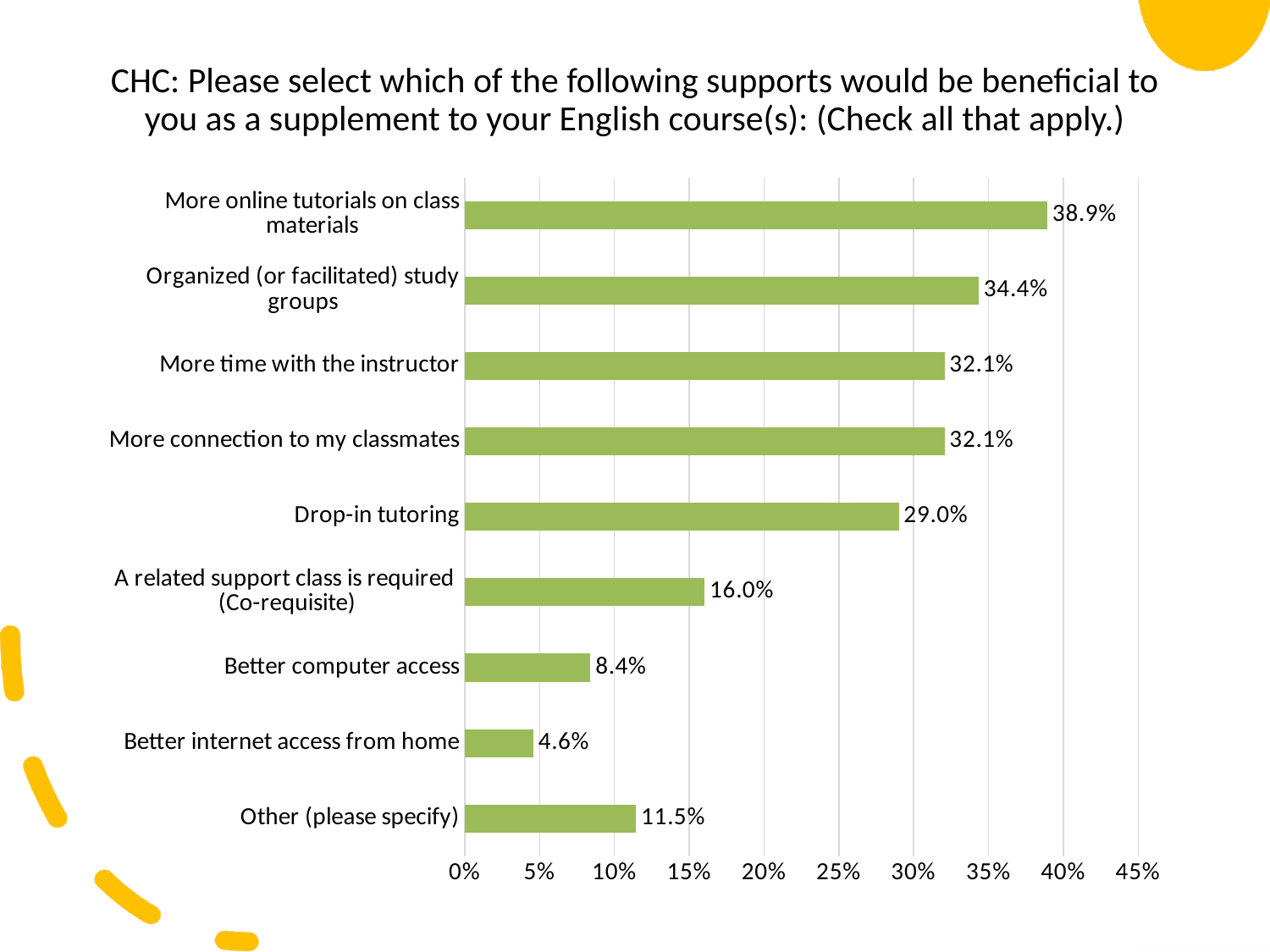
What is the difference between 'More online tutorials on class materials' and 'Organized (or facilitated) study groups'? 4.5% What is the difference between 'Drop-in tutoring' and 'Better computer access'? 20.6% What percentage of respondents selected 'More online tutorials on class materials'? 38.9% Which is larger: 'Better computer access' or 'Other (please specify)'? Other (please specify) Which support option has the highest percentage? More online tutorials on class materials Which support option has the lowest percentage? Better internet access from home What is the value for 'Drop-in tutoring'? 29.0% Is the value for 'A related support class is required (Co-requisite)' greater or less than 20%? less What percentage selected 'Better internet access from home'? 4.6% What is the value for 'Other (please specify)'? 11.5% What kind of chart is shown on the slide? bar chart How many support options are shown in the chart? 9